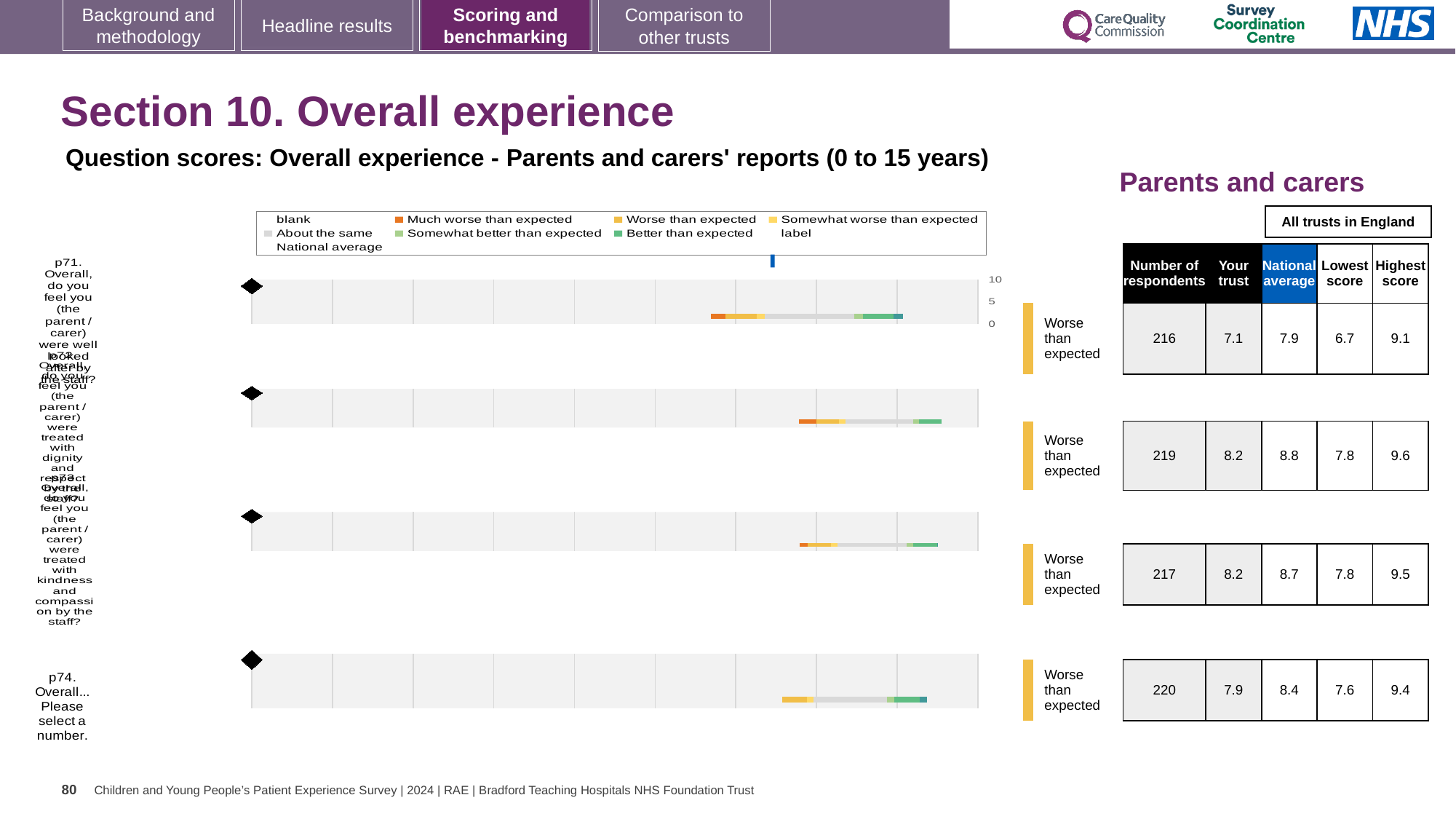
In the Parents and carers table, what is the difference between the National average and the 'Your trust' score for the first row (p71)? 0.8 What kind of chart is used to show the question scores for Overall experience? bar chart In the Parents and carers table, what is the 'Your trust' score for the first row (p71)? 7.1 In the Parents and carers table, which row has the highest Number of respondents? p74 (220) In the Parents and carers table, what is the Number of respondents for the last row (p74)? 220 What is the benchmark label shown to the right of each bar in the Overall experience chart? Worse than expected In the Parents and carers table, what is the National average for the last row (p74)? 8.4 What is the highest value shown on the chart's numeric axis? 10 How many question rows (bars) are shown in the Overall experience chart? 4 In the Parents and carers table, for the last row (p74), which is larger: the 'Your trust' score or the National average? National average In the Parents and carers table, what is the Highest score for the second row? 9.6 In the Parents and carers table, which row has the lowest 'Your trust' score? p71 (7.1)